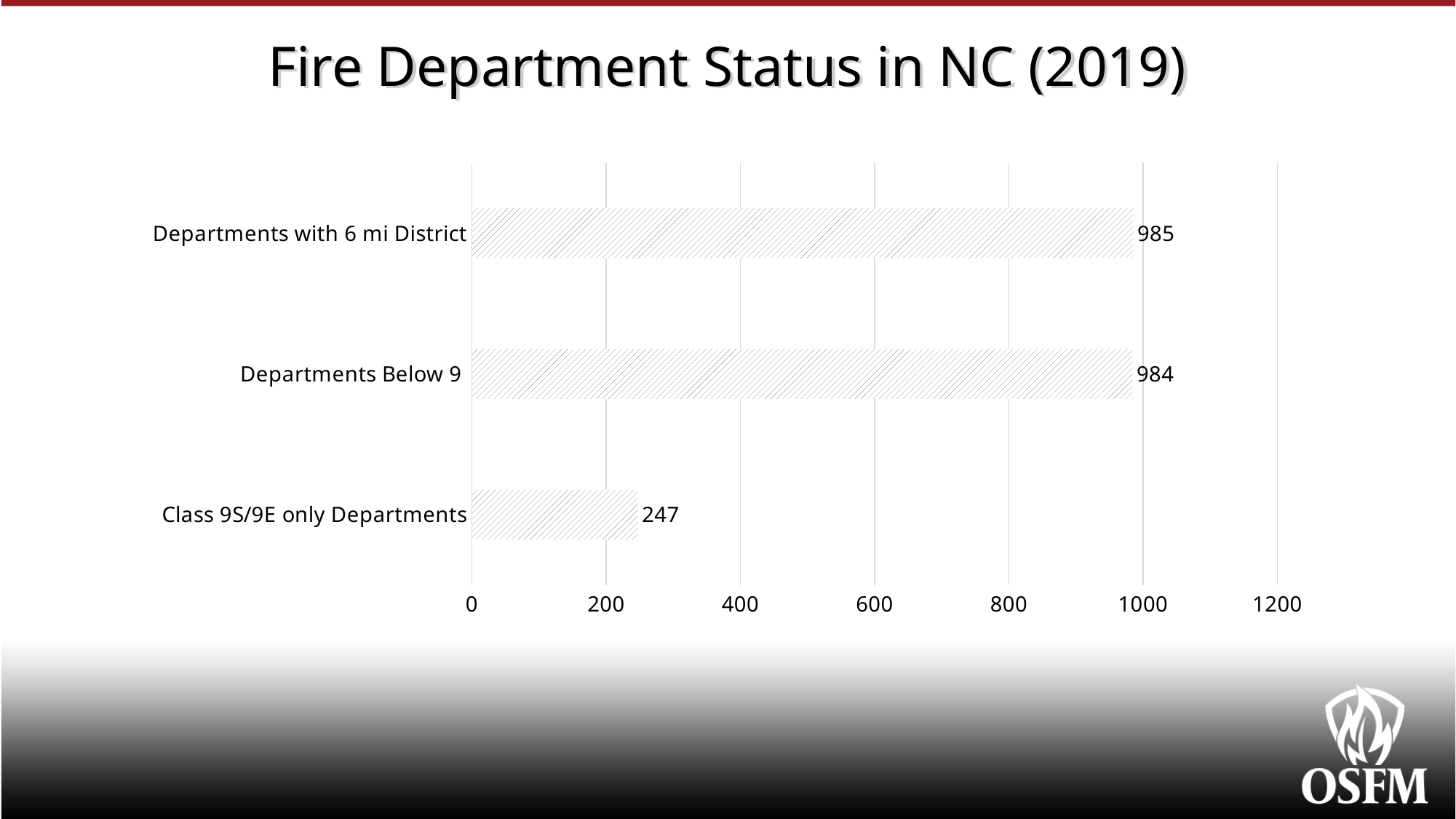
What kind of chart is shown on the slide? bar chart What is the title of the slide? Fire Department Status in NC (2019) Is the value for Class 9S/9E only Departments greater or less than 400? less What is the value for Class 9S/9E only Departments? 247 What is the value for Departments with 6 mi District? 985 What is the difference between the values for Departments Below 9 and Class 9S/9E only Departments? 737 Which category has the lowest value? Class 9S/9E only Departments How many categories are shown in the chart? 3 What is the value for Departments Below 9? 984 What is the difference between the values for Departments with 6 mi District and Class 9S/9E only Departments? 738 Which is larger, the value for Departments Below 9 or the value for Class 9S/9E only Departments? Departments Below 9 Is the value for Departments with 6 mi District greater or less than 800? greater